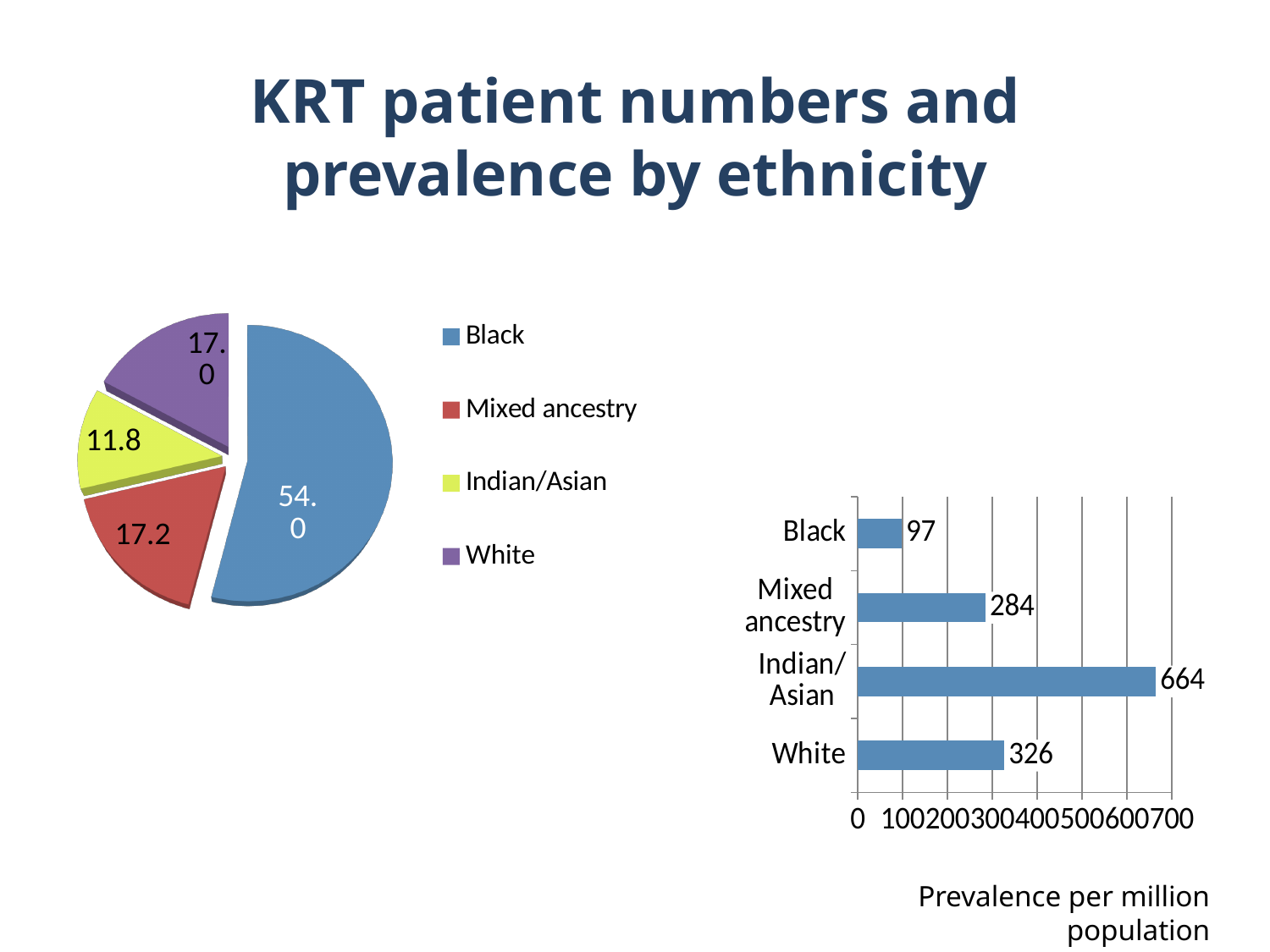
What kind of chart is the chart on the right? Bar chart On the pie chart on the left, what colour is the Mixed ancestry slice? Red On the pie chart on the left, which category has the smallest slice? Indian/Asian On the bar chart on the right, what is the difference between the White and Mixed ancestry values? 42 On the pie chart on the left, how many categories does the legend list? 4 On the bar chart on the right, what is the prevalence per million population for Indian/Asian? 664 On the pie chart on the left, what is the value shown for the Indian/Asian slice? 11.8 On the pie chart on the left, what is the value shown for the Black slice? 54.0 On the bar chart on the right, which is larger, the value for White or the value for Mixed ancestry? White On the bar chart on the right, what is the prevalence per million population for Black? 97 On the pie chart on the left, which category has the largest slice? Black On the bar chart on the right, which category has the highest prevalence per million population? Indian/Asian